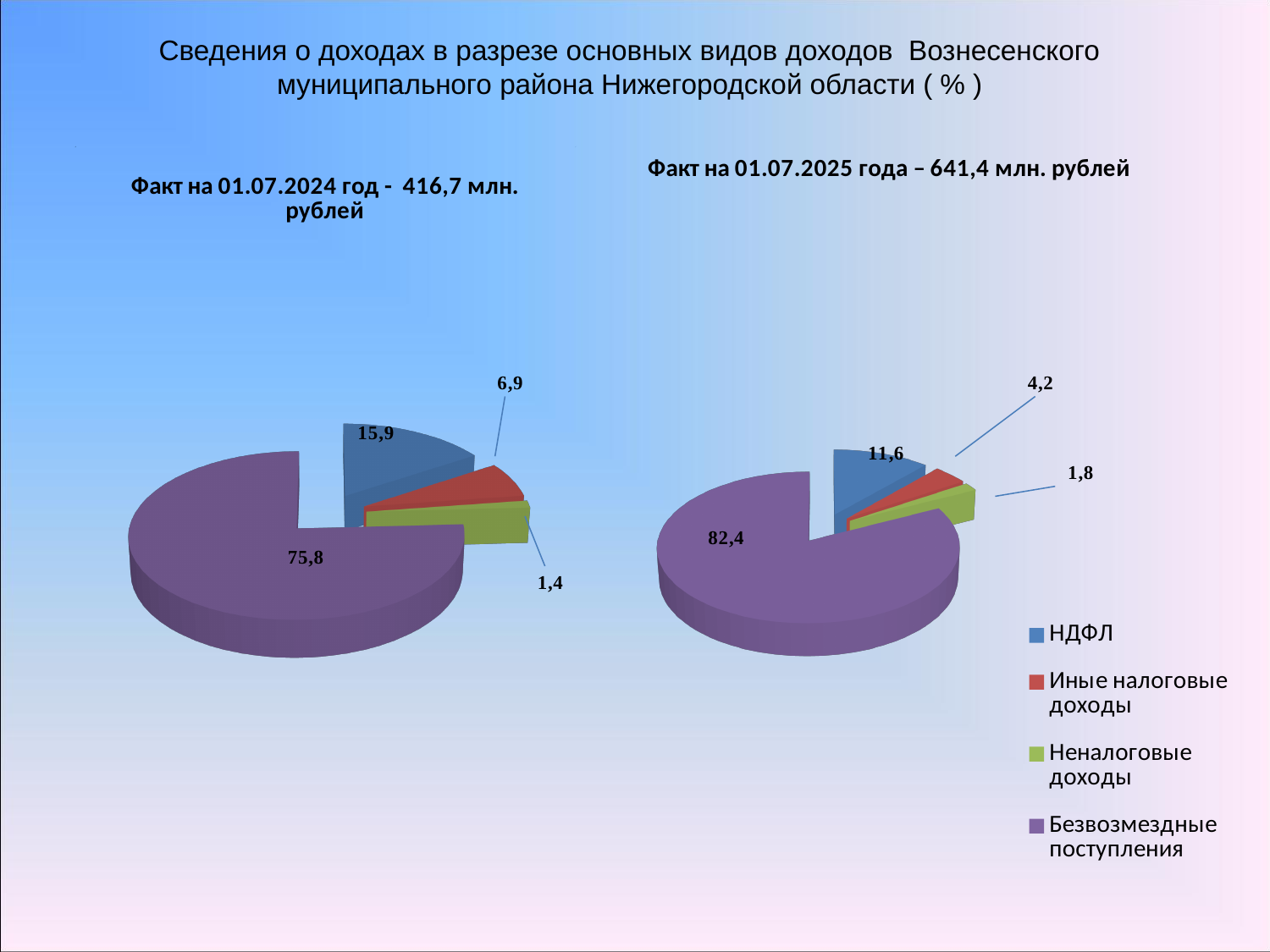
In the right chart (Факт на 01.07.2025 года), what is the value for Неналоговые доходы? 1,8 In the left chart (Факт на 01.07.2024 год), which category has the smallest share? Неналоговые доходы How many slices does the right chart (Факт на 01.07.2025 года) have? 4 Which is larger: the value for НДФЛ in the left chart (01.07.2024) or in the right chart (01.07.2025)? Left chart (01.07.2024) What kind of chart is the left chart (Факт на 01.07.2024 год)? Pie chart In the left chart (Факт на 01.07.2024 год), what is the value for НДФЛ? 15,9 In the right chart (Факт на 01.07.2025 года), which category has the largest share? Безвозмездные поступления In the left chart (Факт на 01.07.2024 год), what is the value for Безвозмездные поступления? 75,8 How many entries does the legend list? 4 In the left chart (Факт на 01.07.2024 год), what is the difference between the values for НДФЛ and Иные налоговые доходы? 9,0 In the right chart (Факт на 01.07.2025 года), what is the value for Иные налоговые доходы? 4,2 What colour represents Безвозмездные поступления in the legend? Purple